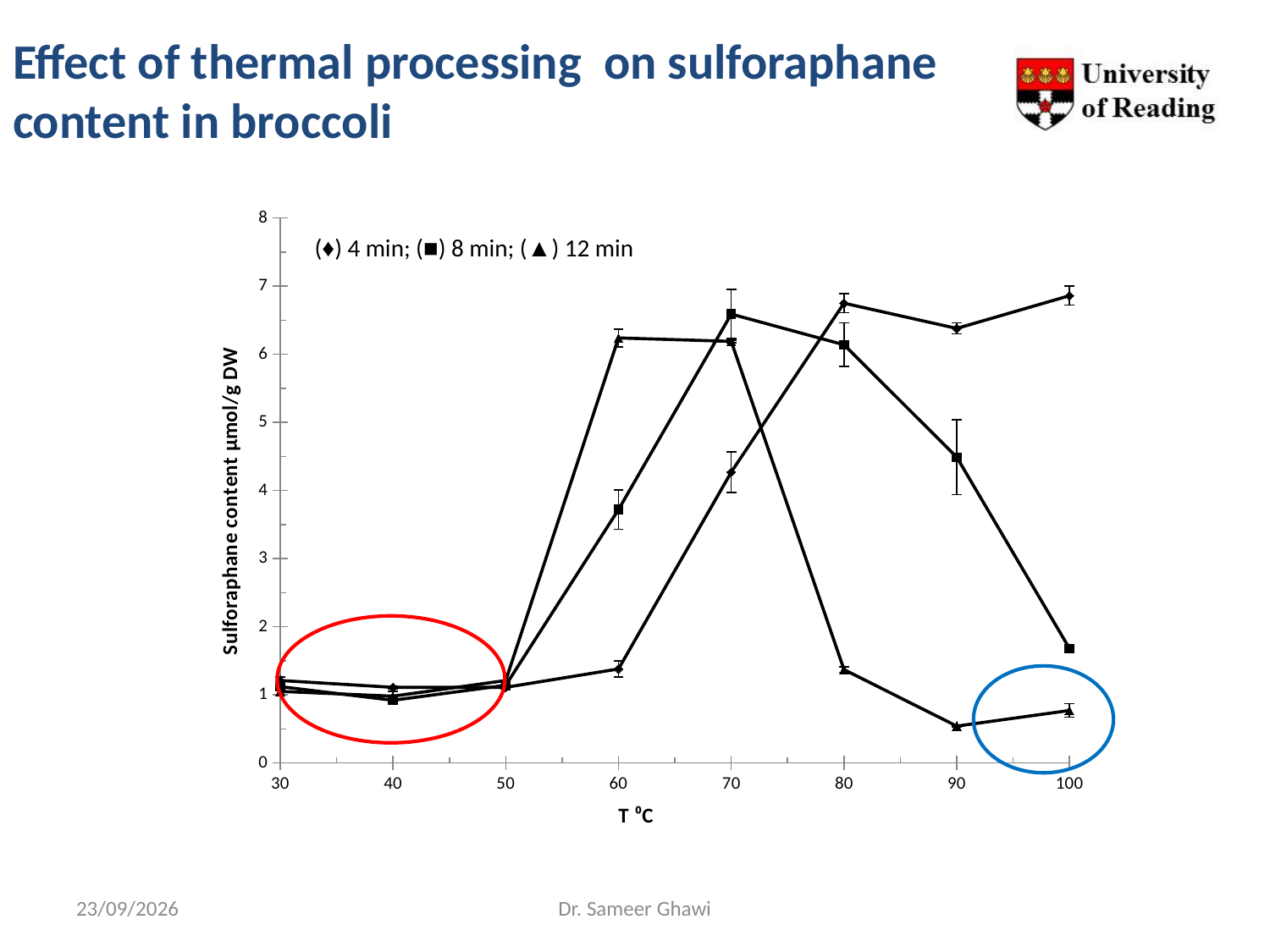
At 100 °C, which series has the larger sulforaphane content, 4 min or 8 min? 4 min Is the value for the 12 min series at 90 °C greater or less than 1? less How many series does the legend list? 3 Which series has the lowest sulforaphane content at 90 °C? 12 min Does the 4 min series rise or fall between 60 °C and 80 °C? rise What kind of chart is shown on the slide? line chart At 60 °C, which series has the larger sulforaphane content, 12 min or 4 min? 12 min Is the value for the 8 min series at 100 °C greater or less than 2? less Is the value for the 8 min series at 60 °C greater or less than 3? greater How many temperature points are plotted along the x axis? 8 What is the label of the y axis? Sulforaphane content µmol/g DW